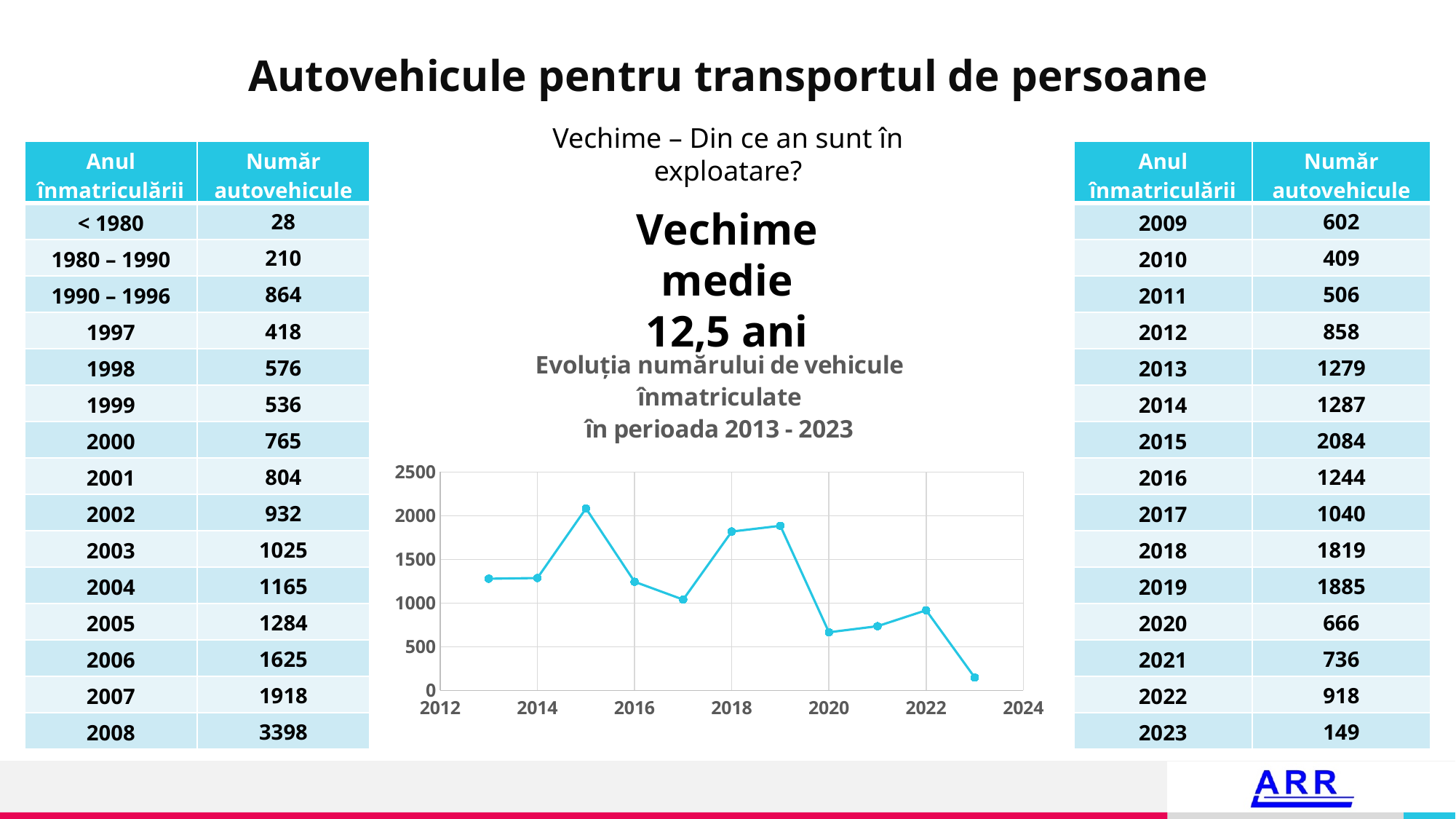
In which year does the line chart reach its highest value? 2015 Do the plotted values rise or fall from 2019 to 2020? fall Is the value plotted for 2020 greater or less than 1000? less Is the value plotted for 2019 greater or less than 1500? greater How many data points are plotted on the line chart? 11 What period does the line chart's title say it covers? 2013 - 2023 What kind of chart is shown under the title 'Evoluția numărului de vehicule înmatriculate în perioada 2013 - 2023'? line chart Is the value plotted for 2013 greater or less than 1000? greater In which year does the line chart reach its lowest value? 2023 Which year has the larger plotted value, 2018 or 2016? 2018